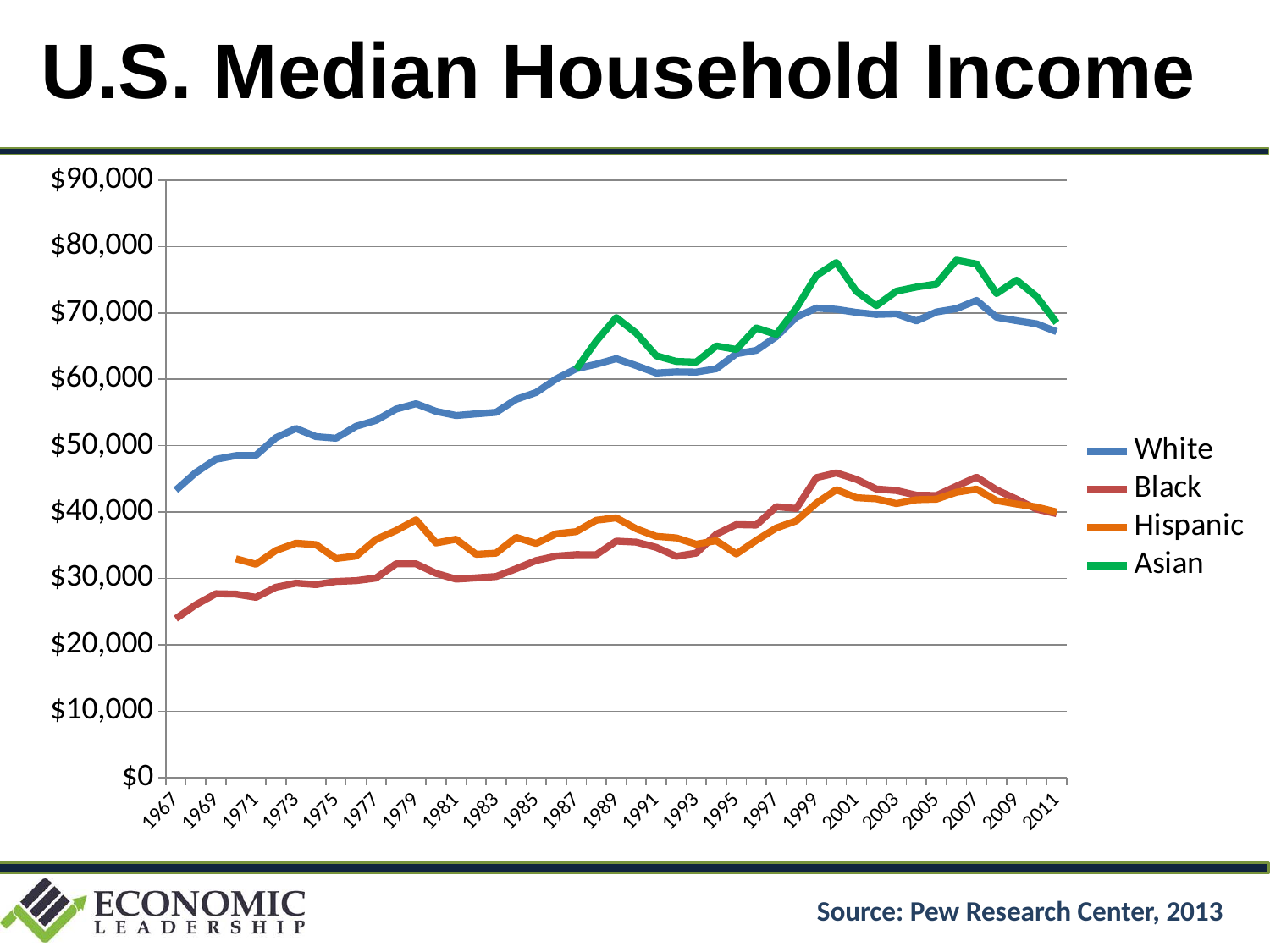
What kind of chart is shown on the slide? Line chart Is the value for Black in 1967 greater or less than $30,000? less Which series has the lowest value in 1985? Black What is the title of the chart? U.S. Median Household Income Is the value for White in 1967 greater or less than $40,000? greater Is the peak value of the Asian series greater or less than $70,000? greater Which series has the highest value in 2007? Asian Which series does the legend list in green? Asian In 1979, which is larger, the value for Hispanic or the value for Black? Hispanic Does the White series generally rise or fall from 1967 to 2011? rise How many series does the legend list? 4